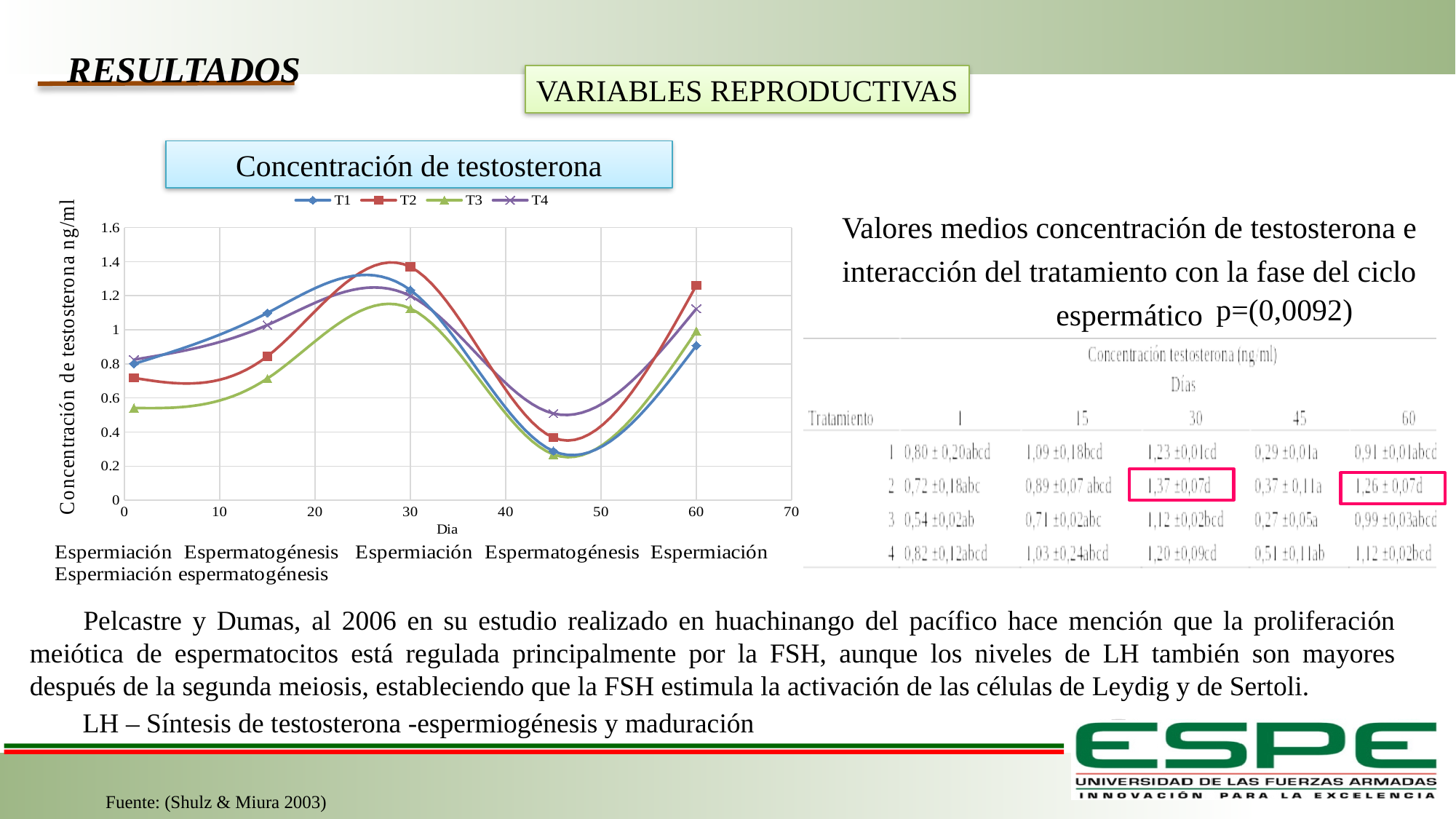
Do the values for T1 rise or fall between day 30 and day 45? fall How many series does the legend of the testosterone concentration chart list? 4 What is the label of the x axis of the testosterone concentration chart? Dia Is the value for T4 at day 45 greater or less than 0.4? greater Is the value for T2 at day 30 greater or less than 1.2? greater How many data points are plotted for series T2 in the testosterone concentration chart? 5 What kind of chart is shown under the heading 'Concentración de testosterona'? line chart Is the value for T3 at day 1 greater or less than 0.6? less Which series has the highest value at day 30 in the testosterone concentration chart? T2 Which series has the lowest value at day 1 in the testosterone concentration chart? T3 At day 30, which is larger in the testosterone concentration chart: T2 or T3? T2